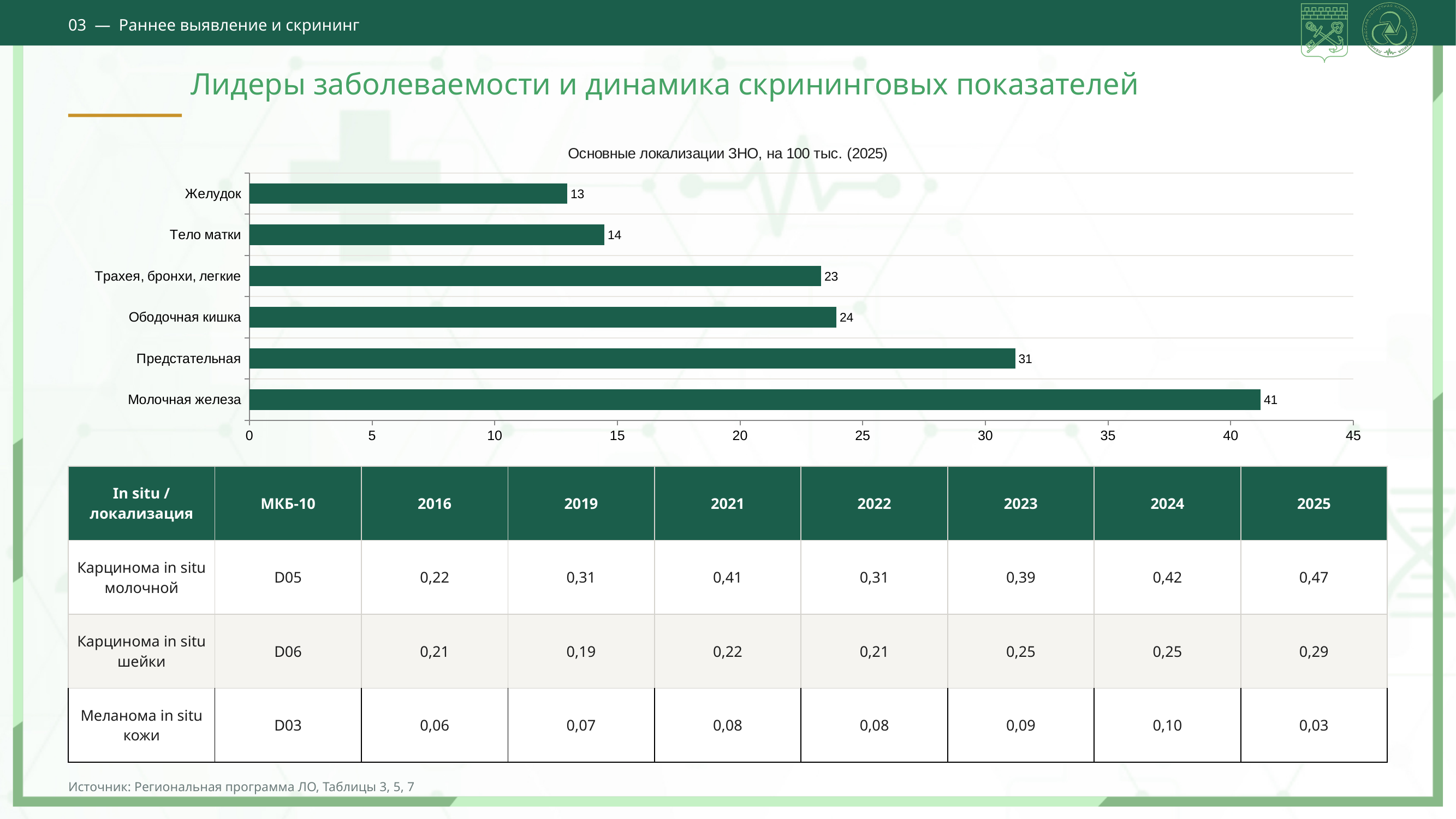
Which is larger: the value for Ободочная кишка or the value for Тело матки? Ободочная кишка How many categories are shown in the chart? 6 What is the difference between the values for Молочная железа and Предстательная? 10 What is the value for Желудок in the chart? 13 What is the value for Молочная железа in the chart? 41 What is the value for Предстательная in the chart? 31 What kind of chart is shown on the slide? bar chart Is the value for Предстательная greater or less than 30? greater What is the title of the chart? Основные локализации ЗНО, на 100 тыс. (2025) Which category has the highest value in the chart? Молочная железа Which category has the lowest value in the chart? Желудок What is the difference between the values for Трахея, бронхи, легкие and Тело матки? 9